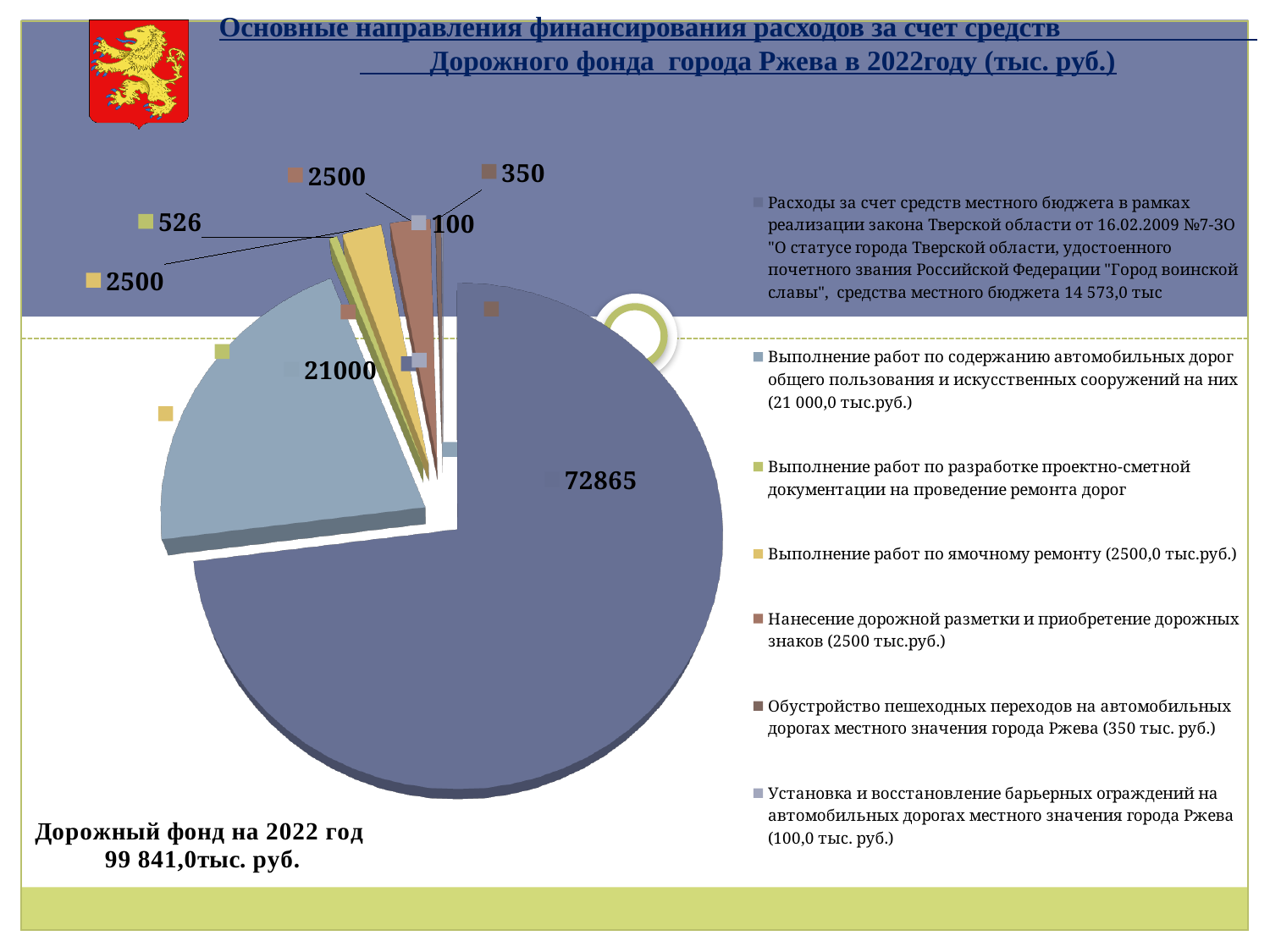
What is the smallest value shown on the pie chart? 100 How many slices does the pie chart have? 7 Which is larger: the value for 'Обустройство пешеходных переходов' or the value for 'Установка и восстановление барьерных ограждений'? Обустройство пешеходных переходов What is the largest value shown on the pie chart? 72865 What value is shown for 'Выполнение работ по содержанию автомобильных дорог общего пользования и искусственных сооружений на них'? 21000 What kind of chart is shown on the slide? pie chart What value is shown for 'Выполнение работ по ямочному ремонту'? 2500 What value is shown for 'Установка и восстановление барьерных ограждений на автомобильных дорогах местного значения города Ржева'? 100 What value is shown for 'Выполнение работ по разработке проектно-сметной документации на проведение ремонта дорог'? 526 What value is shown for 'Обустройство пешеходных переходов на автомобильных дорогах местного значения города Ржева'? 350 How many entries does the legend list? 7 What is the difference between the largest slice (72865) and the slice for содержание автомобильных дорог (21000)? 51865